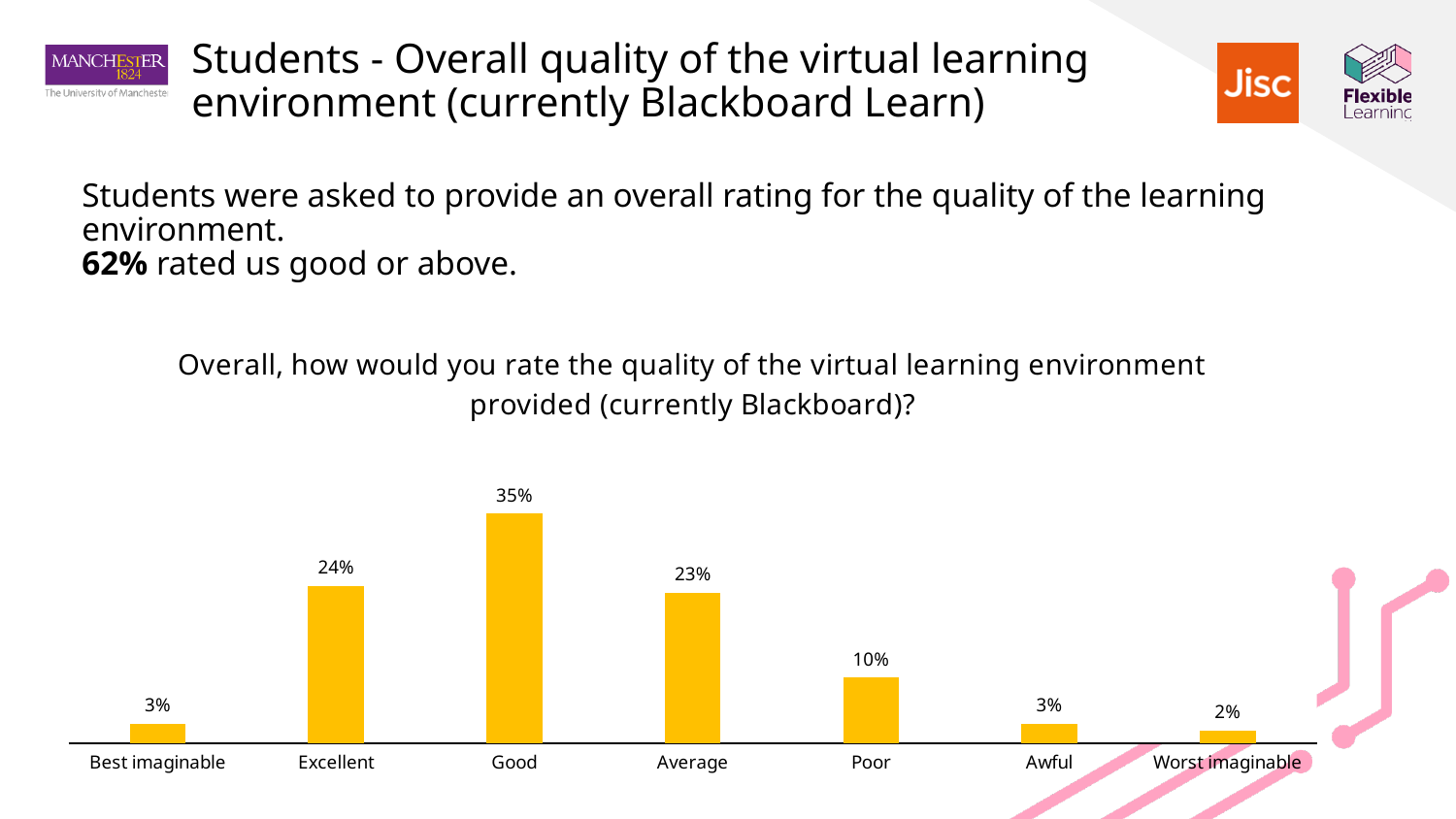
Which rating category has the highest percentage? Good Which rating category has the lowest percentage? Worst imaginable What percentage of students rated the virtual learning environment as Good? 35% What type of chart is shown on the slide? Bar chart What colour are the bars in the chart? Yellow What is the difference in percentage points between the Good and Average ratings? 12 What percentage of students rated the virtual learning environment as Excellent? 24% What is the combined percentage for Best imaginable, Excellent and Good? 62% Which has a larger percentage, Excellent or Average? Excellent What percentage of students rated the virtual learning environment as Worst imaginable? 2% What percentage of students rated the virtual learning environment as Poor? 10% How many rating categories are shown on the chart? 7